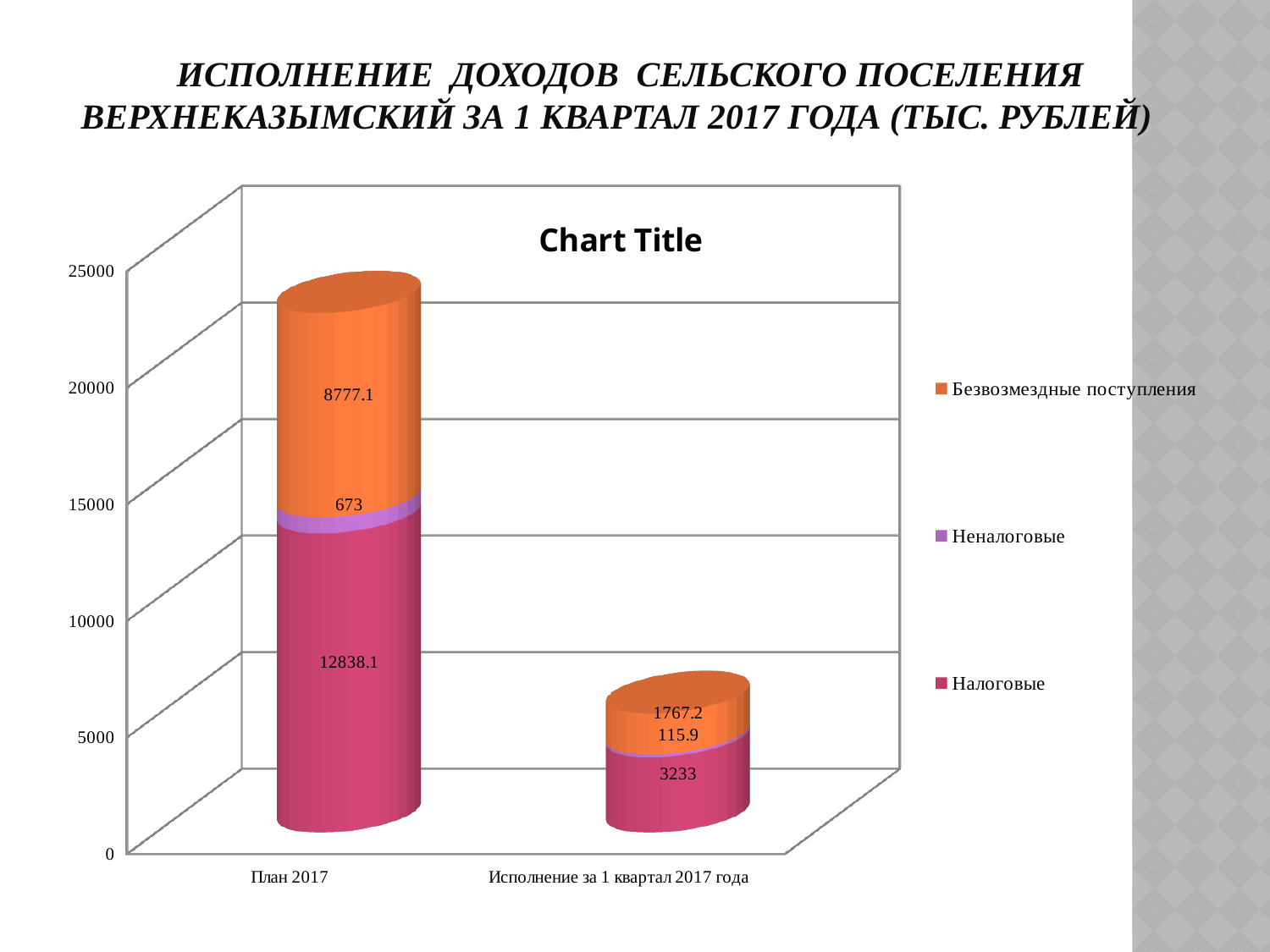
Which series has the lowest value in the Исполнение за 1 квартал 2017 года bar? Неналоговые How many series does the legend list? 3 What is the value of Неналоговые for Исполнение за 1 квартал 2017 года? 115.9 Which series has the highest value in the План 2017 bar? Налоговые What is the value of Неналоговые for План 2017? 673 What is the difference between the Безвозмездные поступления values for План 2017 and Исполнение за 1 квартал 2017 года? 7009.9 What is the total of the stacked bar for Исполнение за 1 квартал 2017 года? 5116.1 What kind of chart is shown on the slide? Stacked bar chart What is the difference between the Налоговые values for План 2017 and Исполнение за 1 квартал 2017 года? 9605.1 Which is larger: Безвозмездные поступления for План 2017 or Налоговые for Исполнение за 1 квартал 2017 года? Безвозмездные поступления for План 2017 What is the value of Безвозмездные поступления for Исполнение за 1 квартал 2017 года? 1767.2 What is the value of Налоговые for План 2017? 12838.1